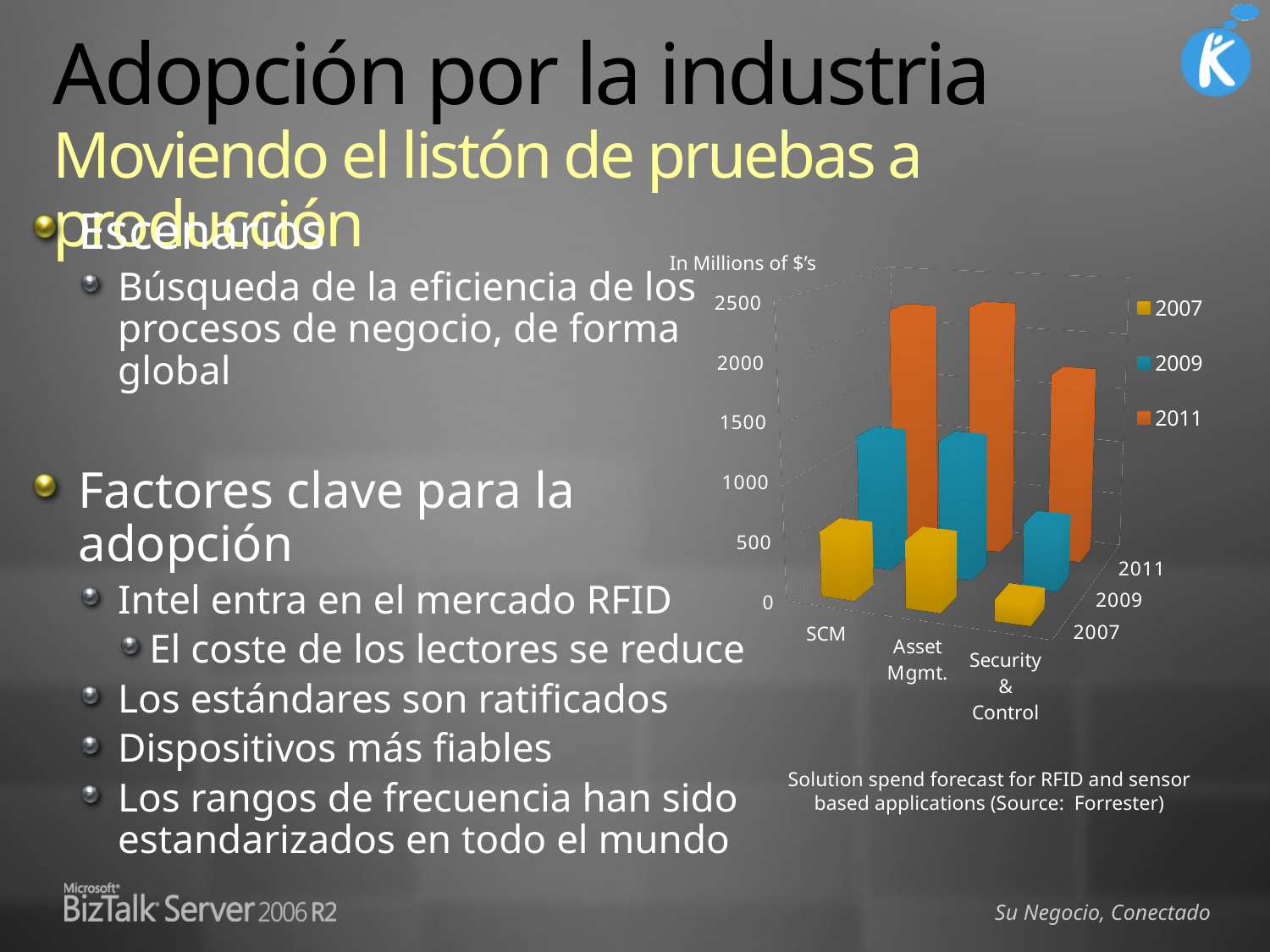
Which years are listed in the chart legend? 2007, 2009, 2011 Is the 2007 value for Security & Control greater or less than 500? less Is the 2009 value for SCM greater or less than 1000? greater How many series does the chart legend list? 3 Is the 2011 value for SCM greater or less than 2000? greater For Asset Mgmt., do the values rise or fall from 2007 to 2011? rise What kind of chart is shown on the slide? bar chart Which category has the lowest value in the 2007 series? Security & Control For SCM, which is larger: the 2007 value or the 2011 value? 2011 What unit label is shown above the value axis of the chart? In Millions of $'s How many categories are shown along the category axis of the chart? 3